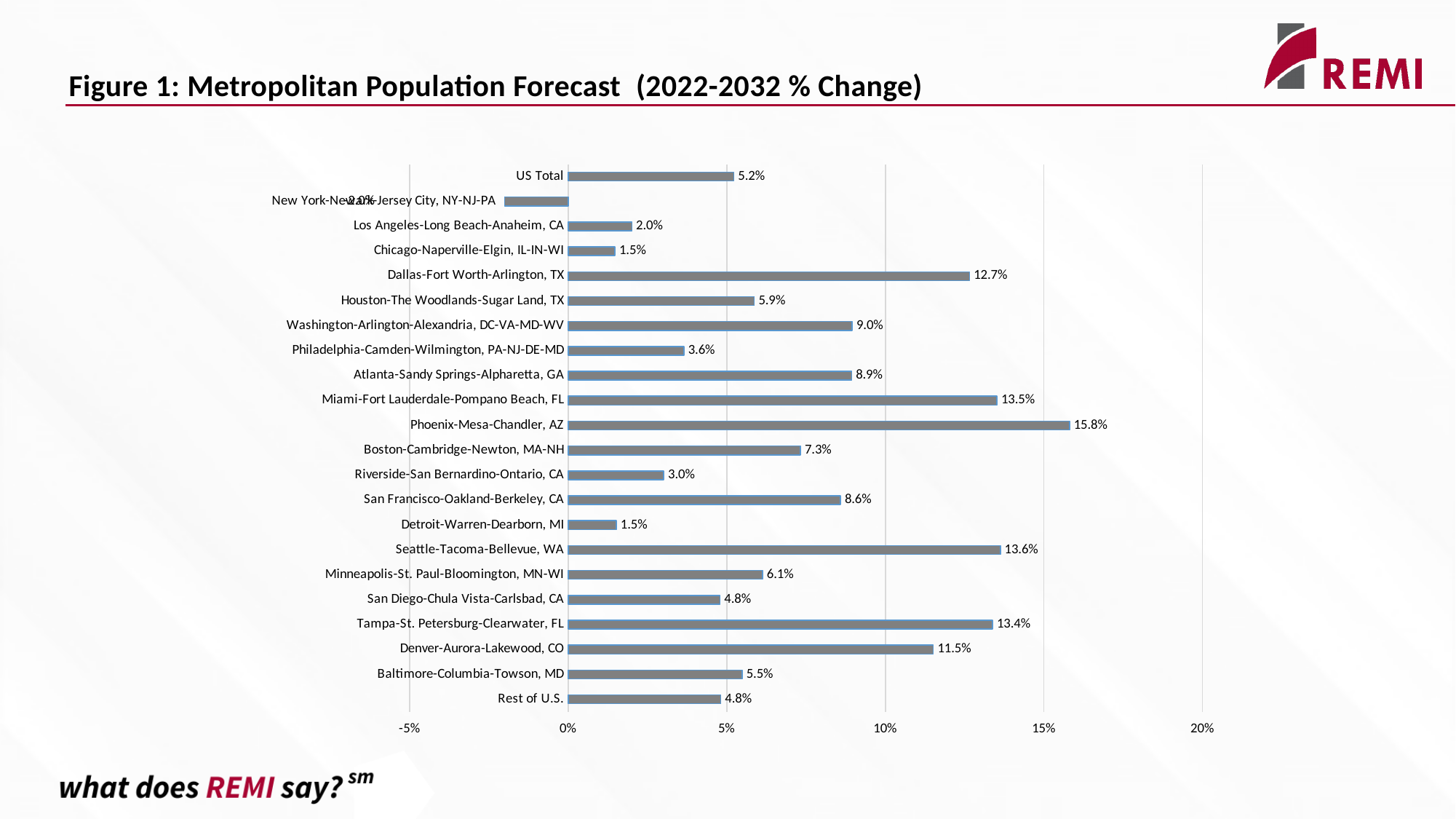
What type of chart is shown on the slide? bar chart How many categories (bars) are shown in the chart? 22 Is the value for New York-Newark-Jersey City, NY-NJ-PA greater or less than 0%? less What is the forecast population change for Dallas-Fort Worth-Arlington, TX? 12.7% What is the difference between the forecast population change for Seattle-Tacoma-Bellevue, WA and Tampa-St. Petersburg-Clearwater, FL? 0.2% What is the forecast population change for the US Total? 5.2% What is the forecast population change for Phoenix-Mesa-Chandler, AZ? 15.8% Which has a larger forecast population change, Miami-Fort Lauderdale-Pompano Beach, FL or Denver-Aurora-Lakewood, CO? Miami-Fort Lauderdale-Pompano Beach, FL Which metropolitan area has the highest forecast population change? Phoenix-Mesa-Chandler, AZ What is the title of the chart on the slide? Figure 1: Metropolitan Population Forecast (2022-2032 % Change) Which metropolitan area has the lowest forecast population change? New York-Newark-Jersey City, NY-NJ-PA What is the difference between the forecast population change for Washington-Arlington-Alexandria, DC-VA-MD-WV and Atlanta-Sandy Springs-Alpharetta, GA? 0.1%